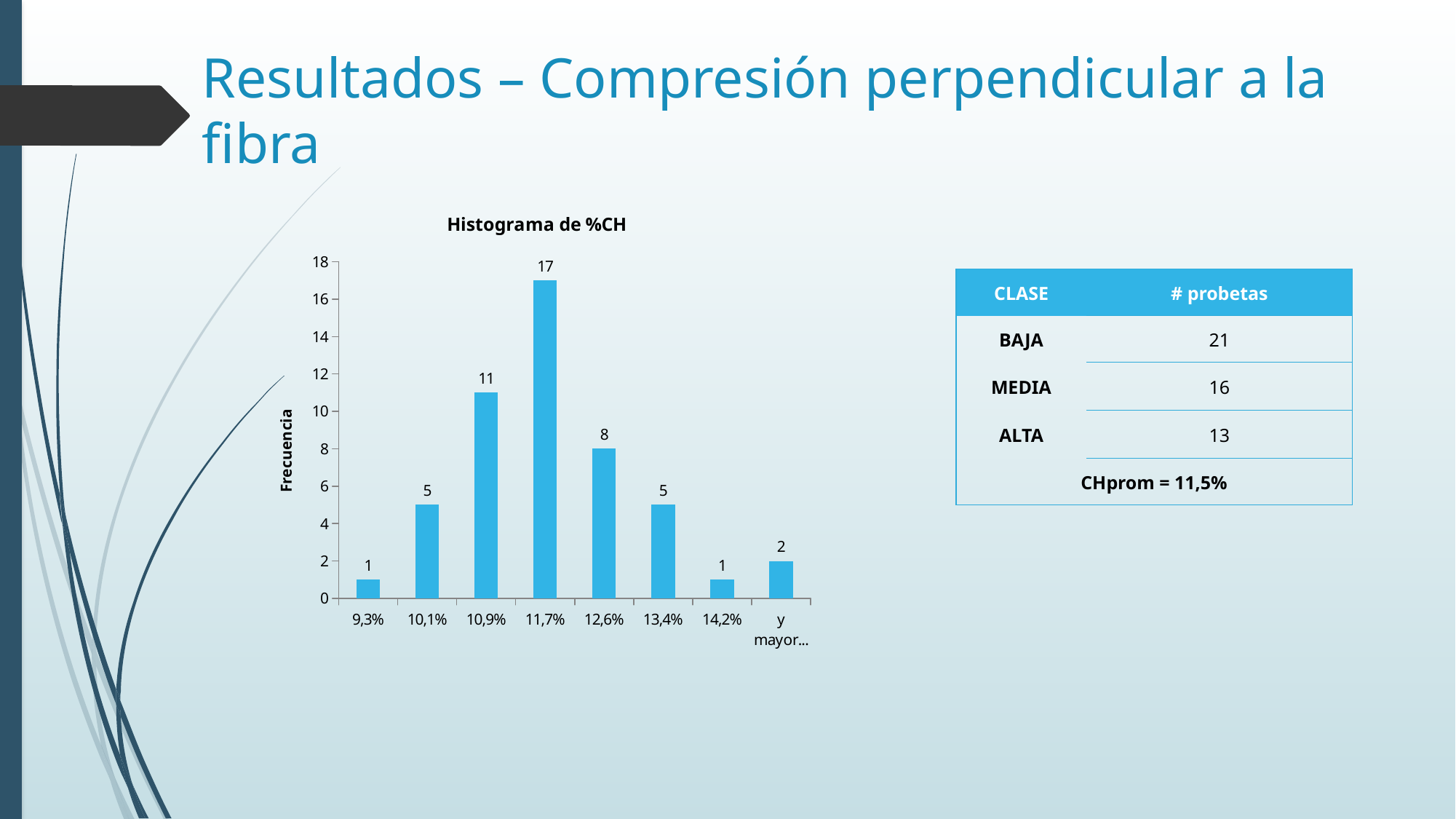
Which has a higher frequency, the 10,1% bin or the 12,6% bin? 12,6% What is the frequency for the 11,7% bin in the histogram? 17 What is the difference in frequency between the 11,7% bin and the 10,9% bin? 6 What is the frequency for the 12,6% bin? 8 What is the title of the chart? Histograma de %CH What kind of chart is shown on the slide? bar chart What is the frequency for the 'y mayor...' bin? 2 What is the frequency for the 10,9% bin? 11 What is the label of the y axis? Frecuencia Which bin has the highest frequency? 11,7% How many bins are shown on the x axis of the histogram? 8 Is the frequency for the 13,4% bin greater or less than 6? less